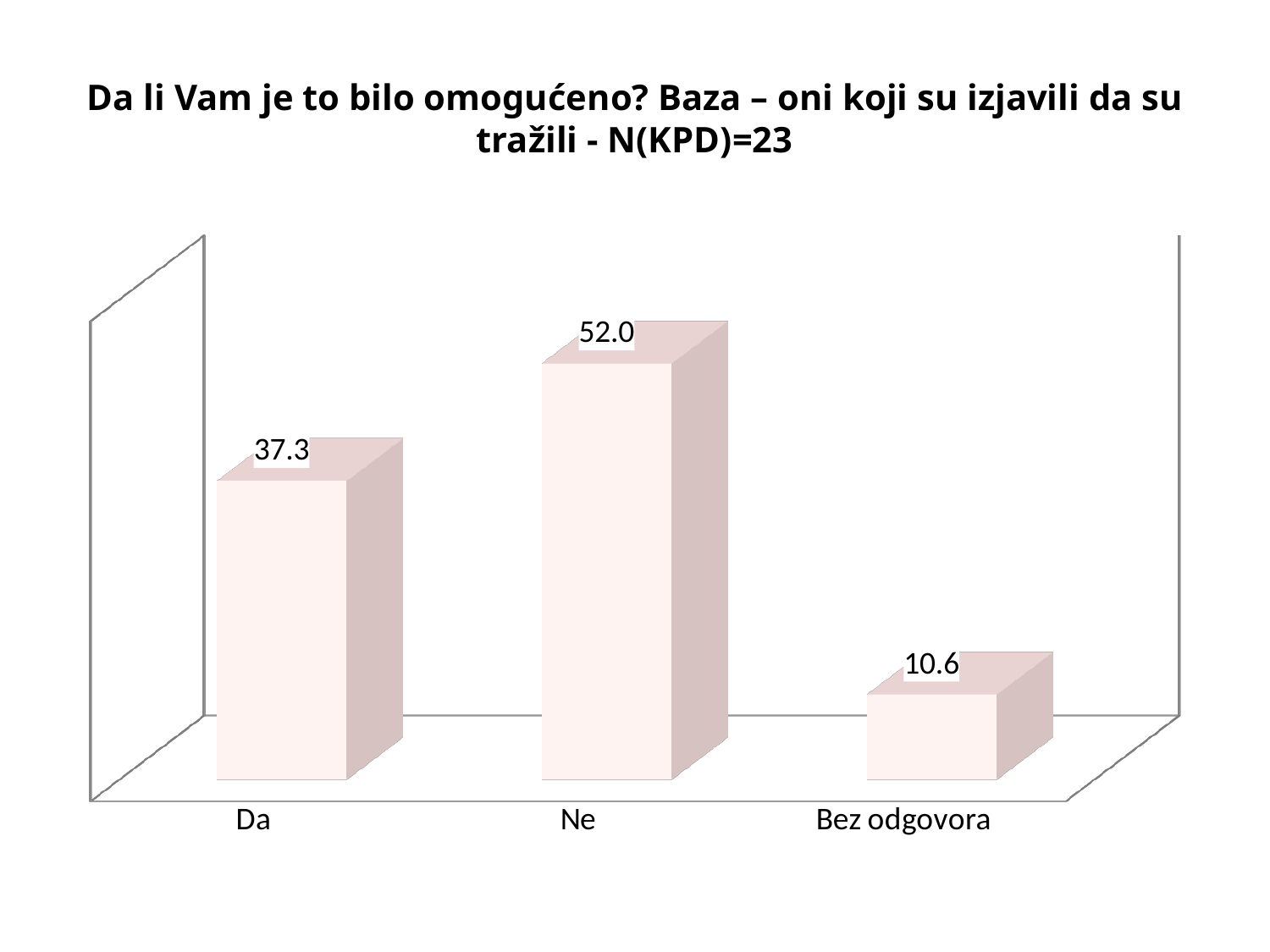
What is the value for "Da"? 37.3 How many categories are shown on the chart? 3 What is the value for "Ne"? 52.0 What kind of chart is shown on the slide? Bar chart What is the difference between the values for "Ne" and "Da"? 14.7 What is the difference between the values for "Da" and "Bez odgovora"? 26.7 What is the value for "Bez odgovora"? 10.6 Which is larger, the value for "Da" or the value for "Ne"? Ne Which category has the highest value? Ne Which category has the lowest value? Bez odgovora What is the label of the category with the value 10.6? Bez odgovora What is the sample size N(KPD) stated in the chart title? 23